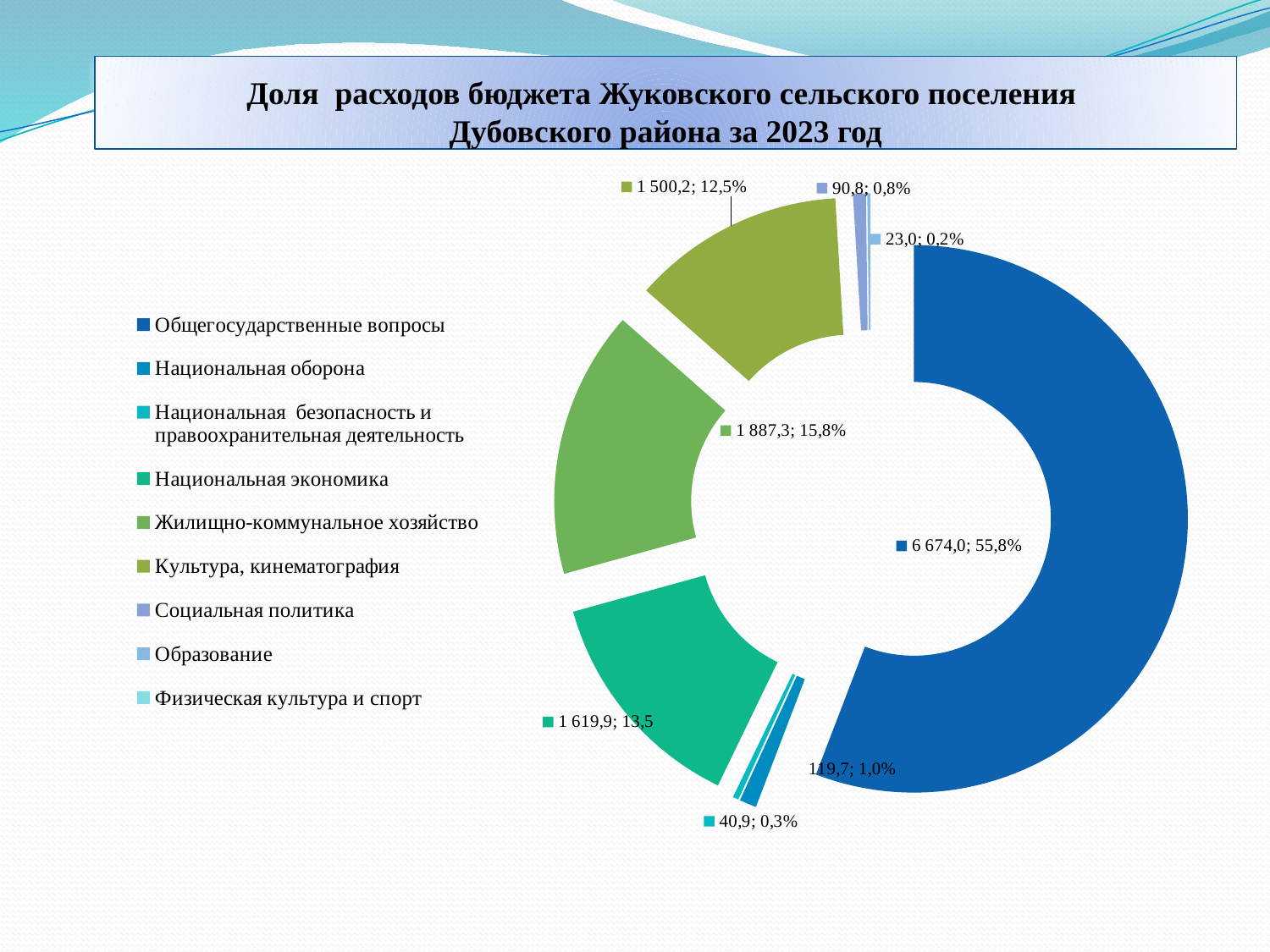
What share is shown for Культура, кинематография? 12,5% Which is larger: the share for Жилищно-коммунальное хозяйство or for Культура, кинематография? Жилищно-коммунальное хозяйство What is the value shown for Социальная политика? 90,8 What share of expenditure does Общегосударственные вопросы account for? 55,8% What is the value shown for Национальная безопасность и правоохранительная деятельность? 40,9 Which category has the largest share of the budget expenditure? Общегосударственные вопросы What is the value shown for Жилищно-коммунальное хозяйство? 1 887,3 How many categories does the legend list? 9 What is the difference in value between Общегосударственные вопросы and Жилищно-коммунальное хозяйство? 4 786,7 What share is shown for Национальная оборона? 1,0% What is the title of the chart? Доля расходов бюджета Жуковского сельского поселения Дубовского района за 2023 год What kind of chart is shown on the slide? pie (doughnut) chart